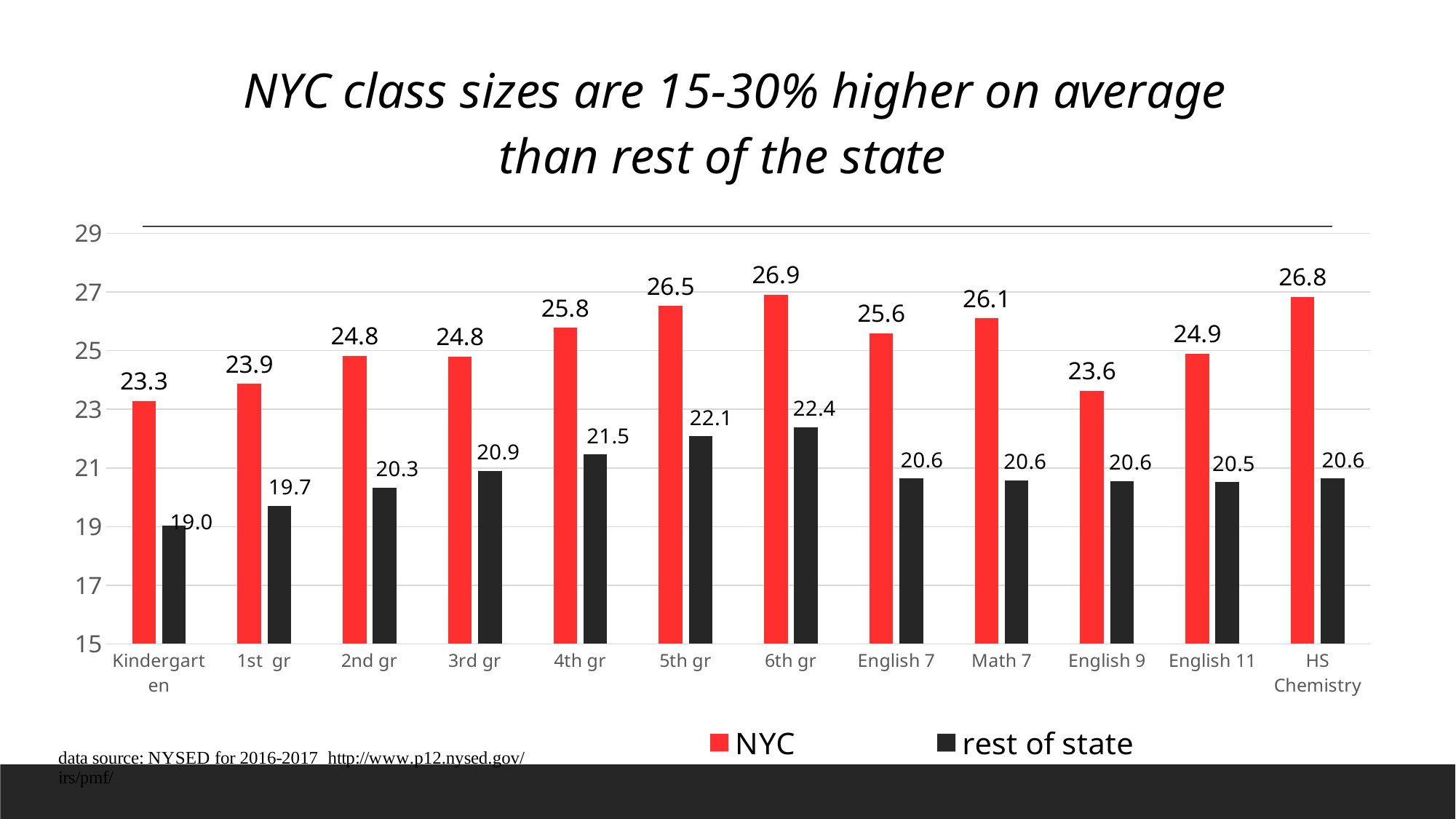
What kind of chart is shown on the slide? bar chart How many series does the legend list? 2 Which category has the highest NYC class size? 6th gr Which category has the lowest rest of state class size? Kindergarten What is the rest of state value for 4th gr? 21.5 Which is larger, the NYC value for English 7 or the NYC value for Math 7? Math 7 How many categories are shown on the x axis? 12 What is the NYC average class size for 6th gr? 26.9 What is the difference between the NYC and rest of state values for 5th gr? 4.4 Is the NYC value for HS Chemistry greater or less than 25? greater What colour are the NYC bars? red What is the rest of state average class size for Kindergarten? 19.0